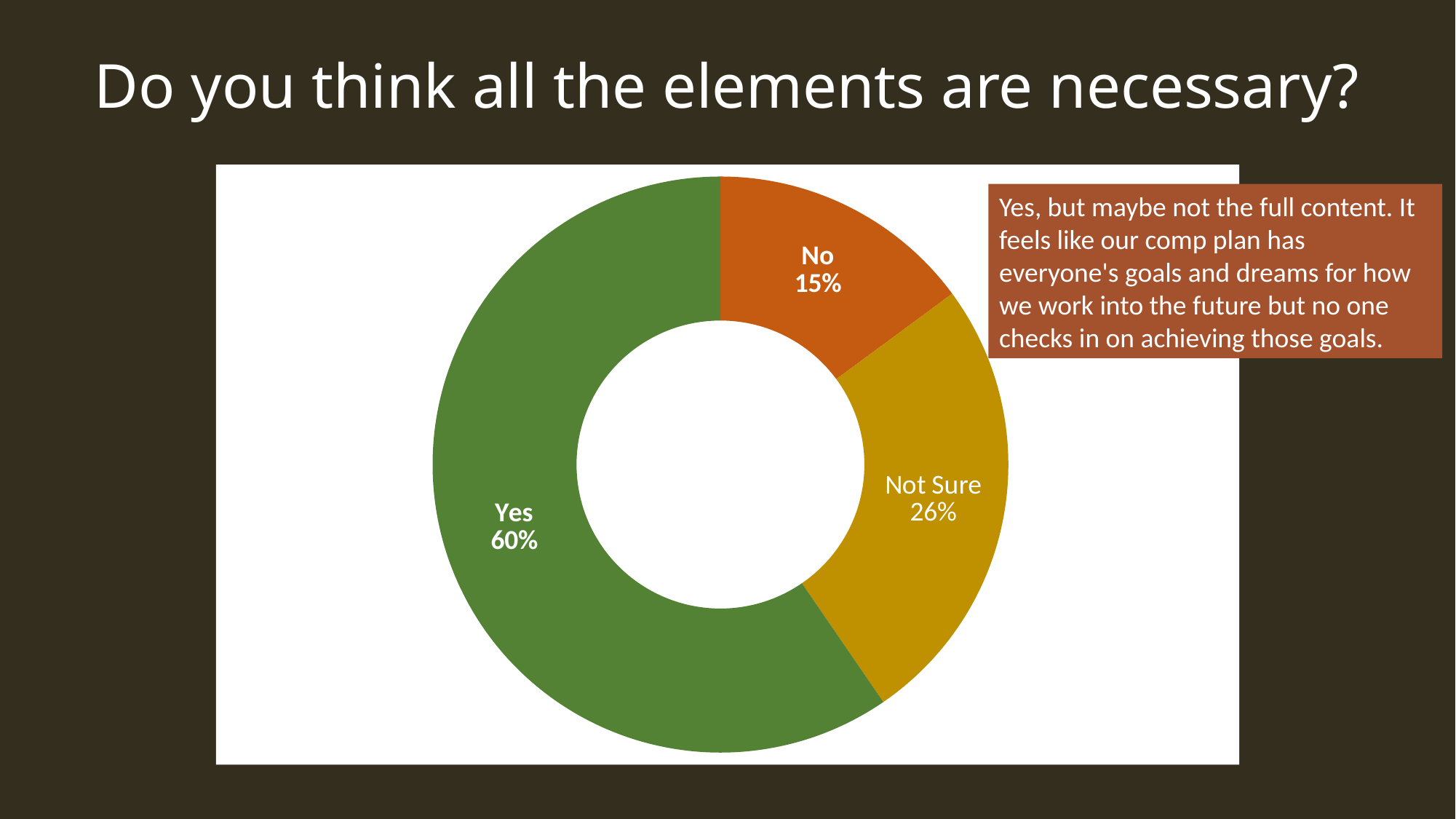
What question does the slide title ask? Do you think all the elements are necessary? Which response has the smallest share of the chart? No What kind of chart is shown on the slide? Doughnut chart Which response has the largest share of the chart? Yes What colour is the Yes segment of the chart? Green What percentage of respondents answered Not Sure? 26% Which is larger, the share for Not Sure or the share for No? Not Sure How many response categories are shown in the chart? 3 What percentage of respondents answered No? 15% What percentage of respondents answered Yes? 60% What is the difference in percentage points between Not Sure and No? 11 What is the difference in percentage points between Yes and Not Sure? 34